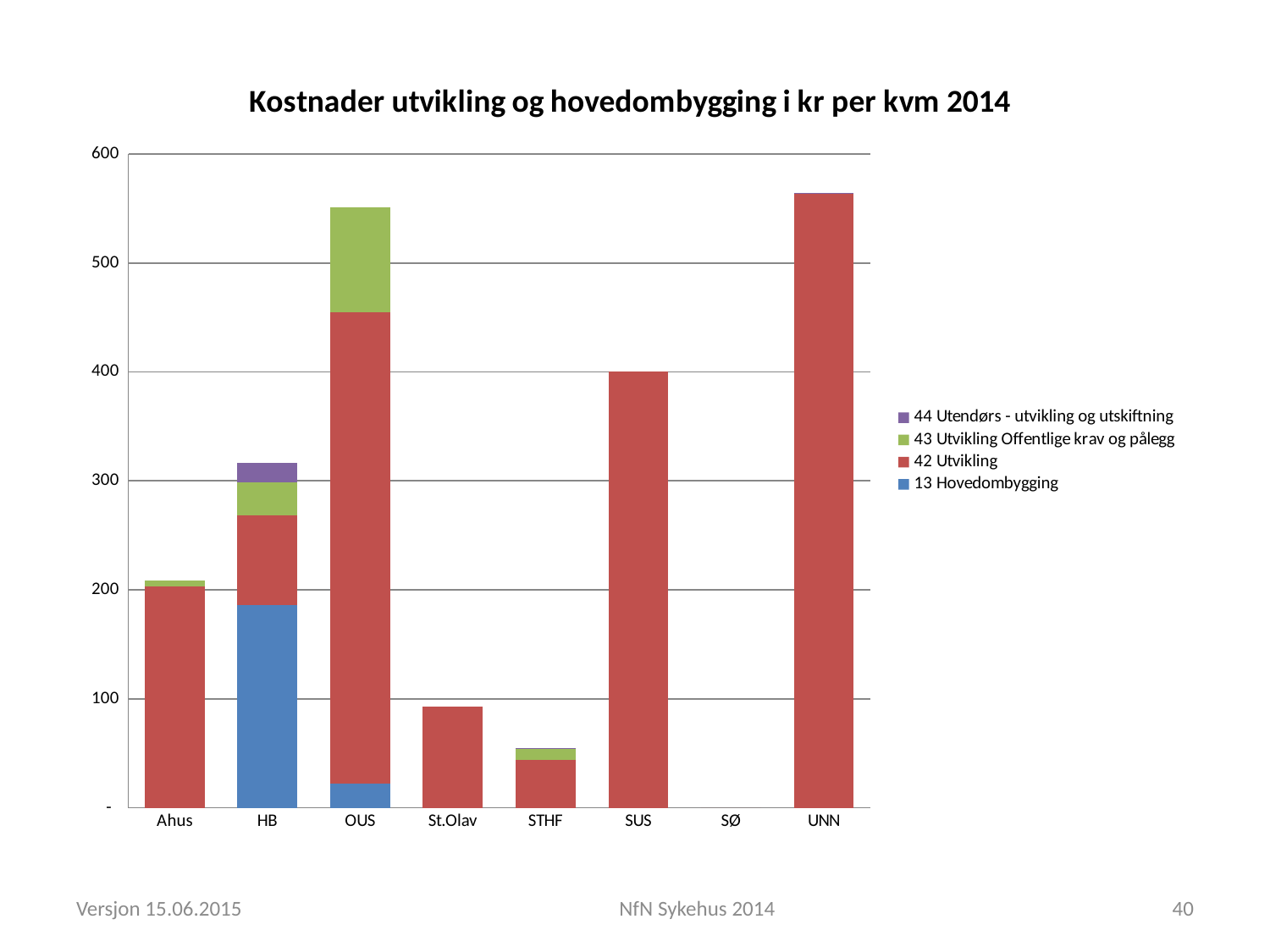
How many series does the legend list? 4 Is the total value for St.Olav greater or less than 100? less Is the total value for HB greater or less than 300? greater How many hospitals (categories) are shown on the x axis? 8 Which hospital has the lowest total cost in the chart? SØ Is the total value for UNN greater or less than 500? greater Which has the larger total value, SUS or St.Olav? SUS Which has the larger total value, OUS or SUS? OUS What kind of chart is shown on the slide? stacked bar chart What is the title of the chart? Kostnader utvikling og hovedombygging i kr per kvm 2014